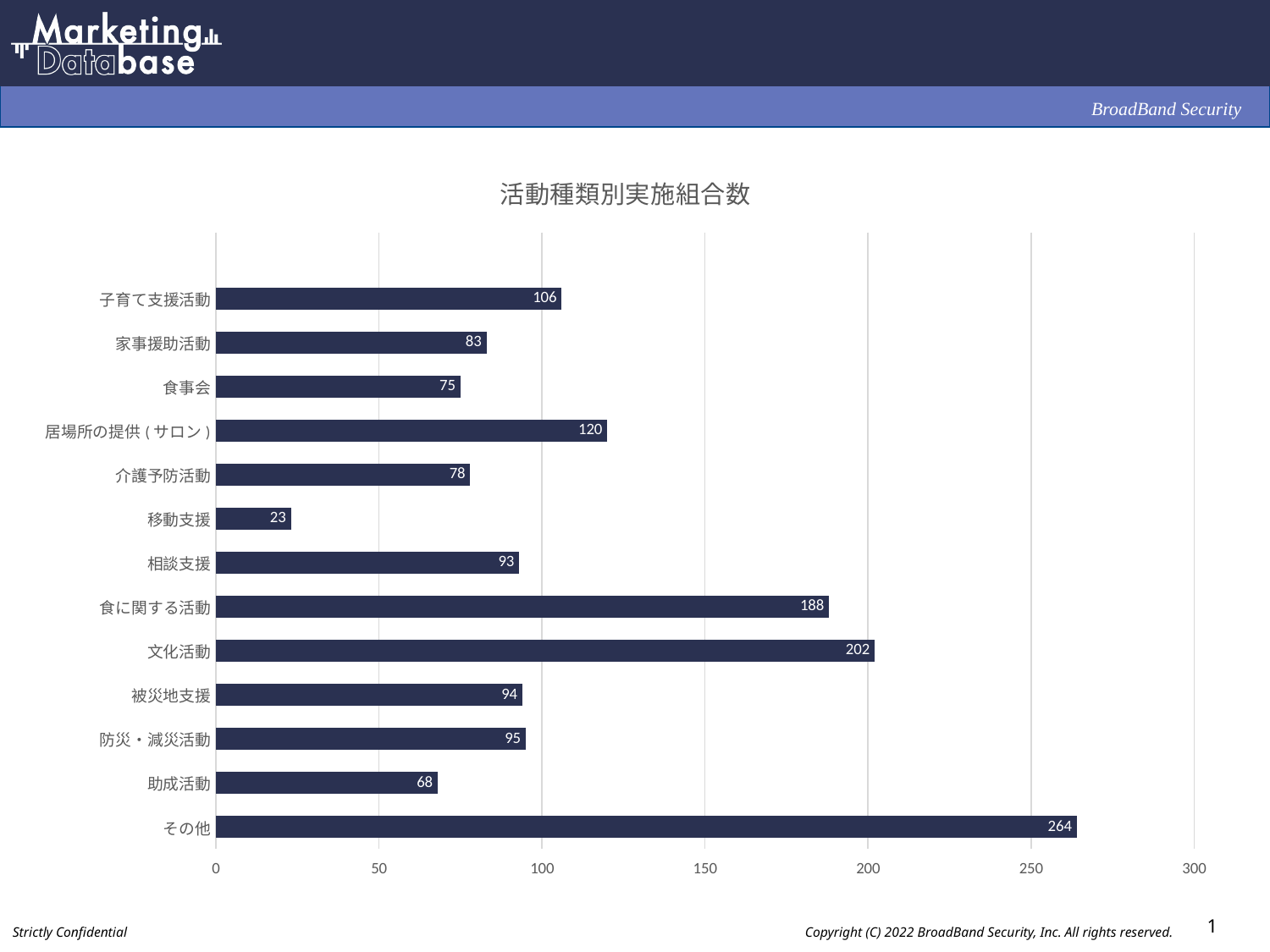
Which is larger, the value for 食に関する活動 or the value for 居場所の提供(サロン)? 食に関する活動 What is the value for 居場所の提供(サロン)? 120 Which category has the lowest value? 移動支援 What is the title of the chart? 活動種類別実施組合数 What is the difference between the values for 子育て支援活動 and 家事援助活動? 23 Is the value for 助成活動 greater or less than 100? less What is the difference between the values for その他 and 文化活動? 62 Which category has the highest value? その他 How many categories are shown in the chart? 13 What kind of chart is shown on the slide? bar chart What is the value for 文化活動? 202 What is the value for 移動支援? 23